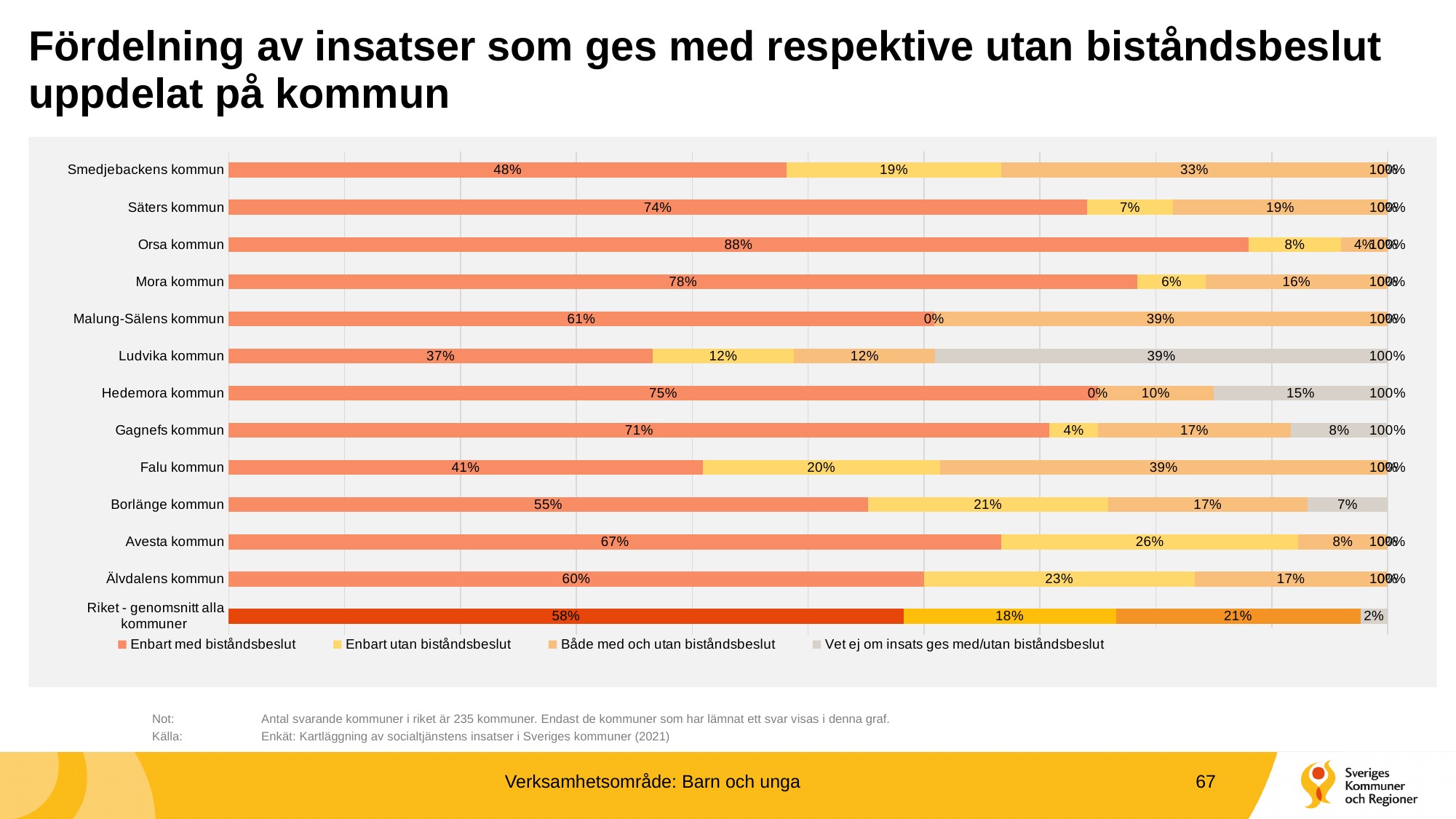
Which series is shown in the grey colour in the legend? Vet ej om insats ges med/utan biståndsbeslut Which kommun has the highest share of 'Enbart med biståndsbeslut'? Orsa kommun What is the value of 'Vet ej om insats ges med/utan biståndsbeslut' for Ludvika kommun? 39% What kind of chart is shown on the slide? Stacked bar chart Which kommun has the lowest share of 'Enbart med biståndsbeslut'? Ludvika kommun What is the difference in 'Enbart med biståndsbeslut' between Orsa kommun and Ludvika kommun? 51 percentage points How many categories (rows) are plotted in the chart? 13 What is the value of 'Enbart med biståndsbeslut' for Orsa kommun? 88% How many series does the legend list? 4 What is the value of 'Enbart utan biståndsbeslut' for Avesta kommun? 26% Which has a larger share of 'Enbart med biståndsbeslut', Smedjebackens kommun or Falu kommun? Smedjebackens kommun What is the value of 'Både med och utan biståndsbeslut' for Riket - genomsnitt alla kommuner? 21%